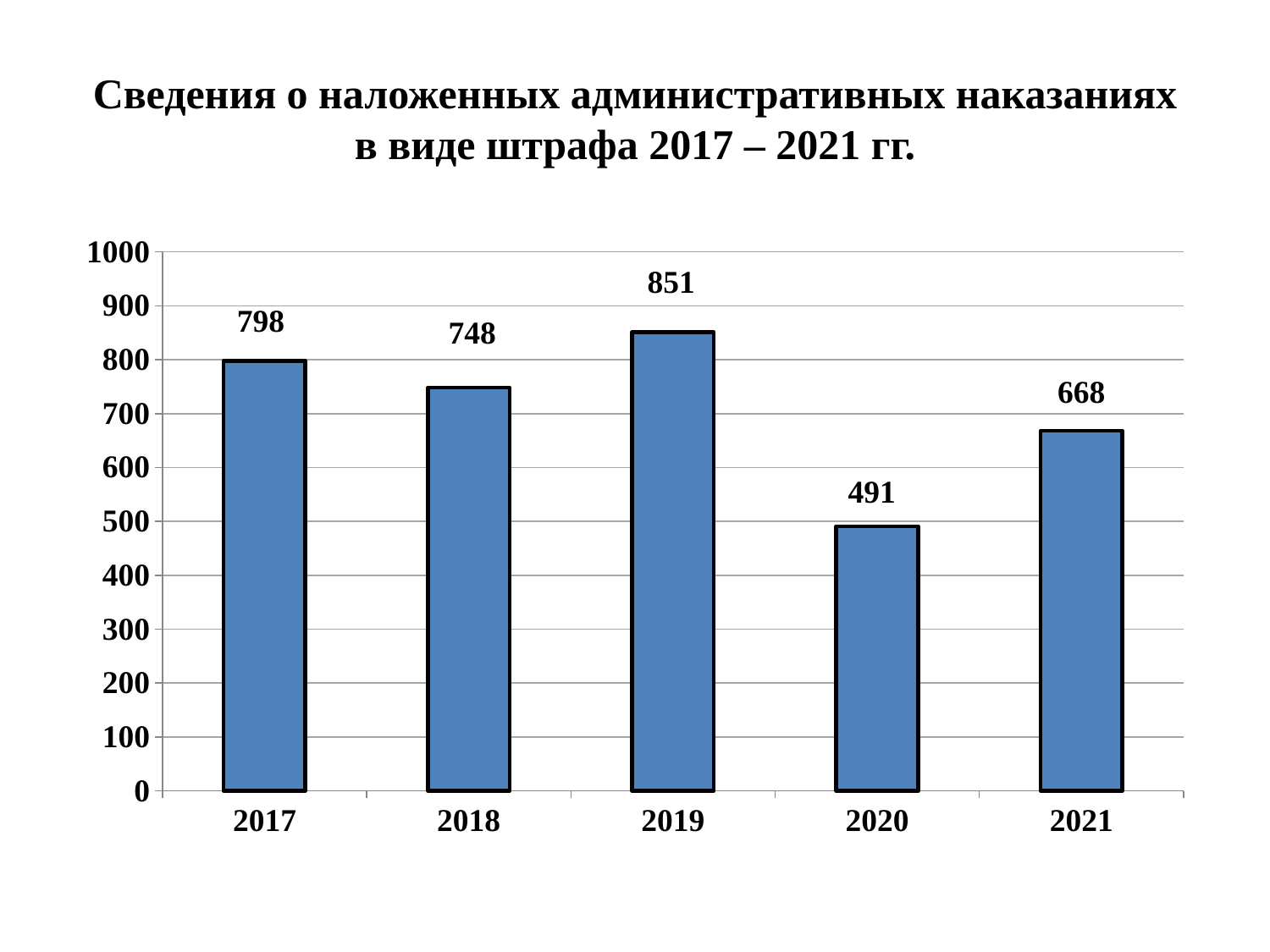
Which year has the lowest value? 2020 What is the value for 2020? 491 What kind of chart is shown on the slide? bar chart Is the value for 2020 greater or less than 500? less What is the difference between the values for 2019 and 2020? 360 Which is larger, the value for 2018 or the value for 2021? 2018 What is the difference between the values for 2017 and 2018? 50 What is the value for 2021? 668 How many years are shown on the chart? 5 What is the value for 2017? 798 Does the value rise or fall from 2019 to 2020? fall Which year has the highest value? 2019